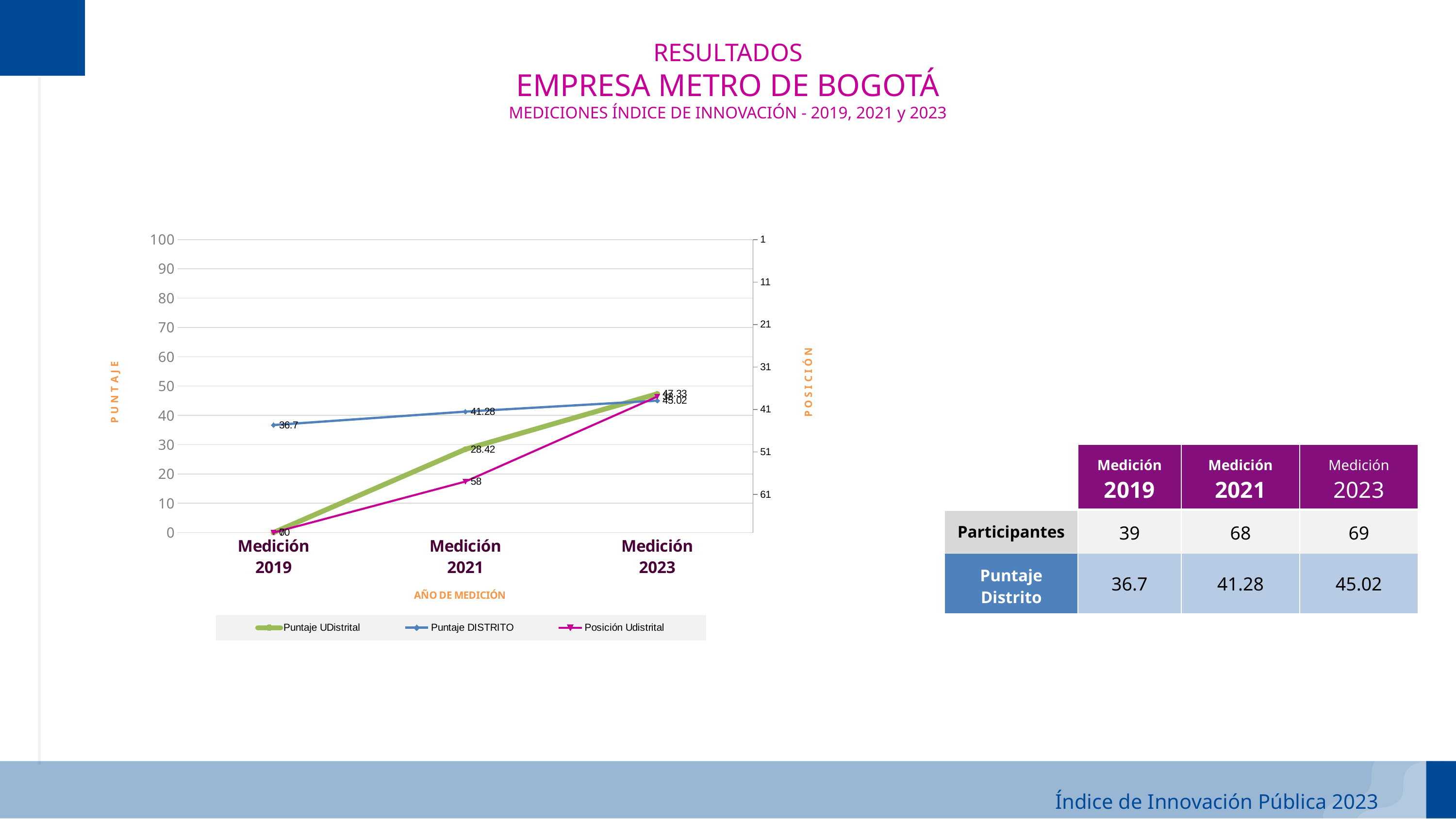
What is the difference between the Puntaje DISTRITO values for Medición 2023 and Medición 2019? 8.32 What is the Puntaje DISTRITO value for Medición 2019? 36.7 For Medición 2021, which is larger: Puntaje DISTRITO or Puntaje UDistrital? Puntaje DISTRITO What is the title of the x axis of the chart? AÑO DE MEDICIÓN What is the Puntaje DISTRITO value for Medición 2023? 45.02 How many series does the chart legend list? 3 How many measurement years are shown on the x axis of the chart? 3 What is the Puntaje DISTRITO value for Medición 2021? 41.28 Does the Puntaje DISTRITO series rise or fall from Medición 2019 to Medición 2023? rise What is the Posición Udistrital value for Medición 2021? 58 What is the Puntaje UDistrital value for Medición 2021? 28.42 What kind of chart is shown on the slide? line chart